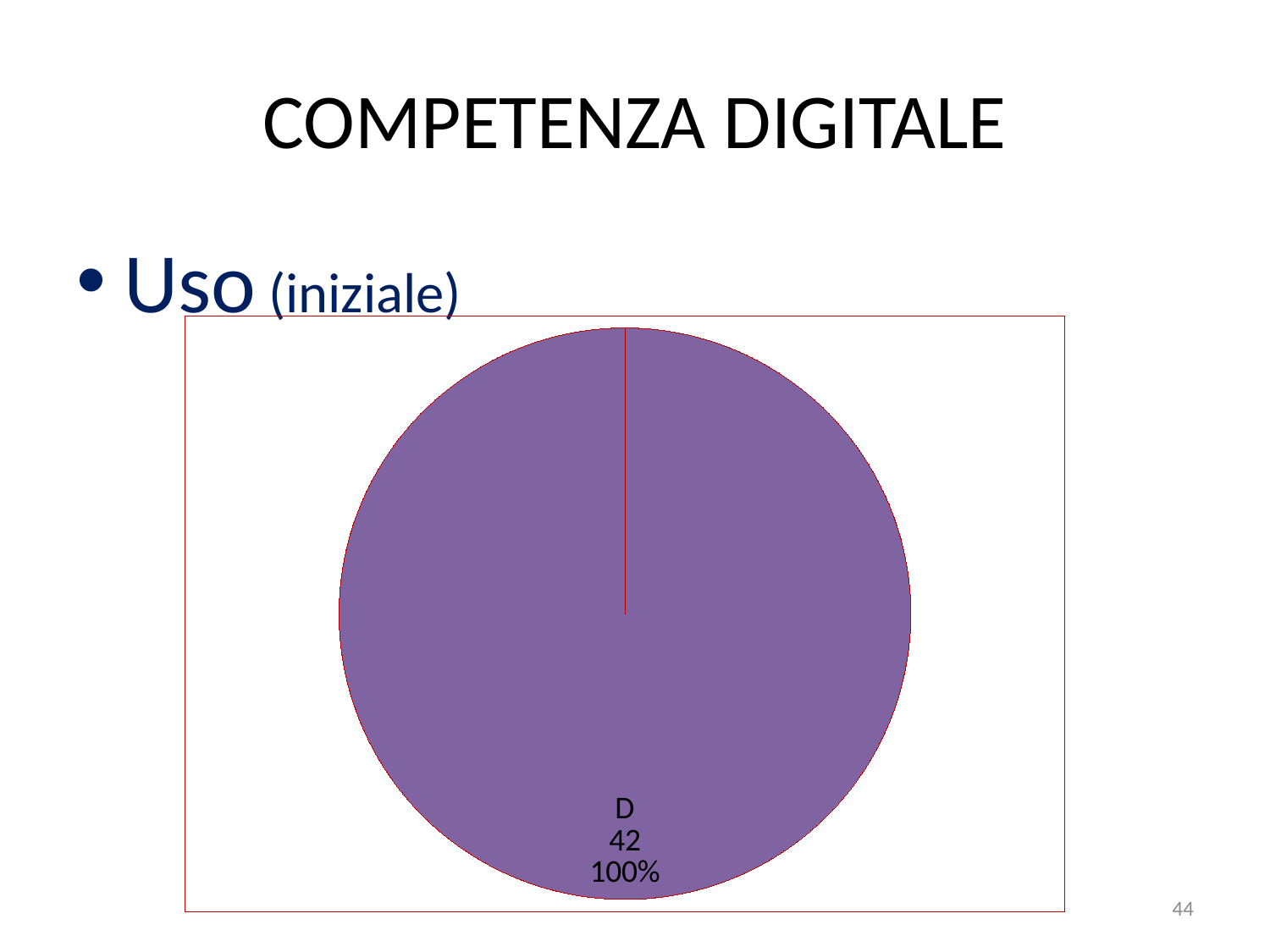
What percentage share of the pie does category D have? 100% Is the value for D in the pie chart greater or less than 40? greater What kind of chart is shown on the slide? pie chart What colour is the slice in the pie chart? purple What is the label of the only slice in the pie chart? D How many slices does the pie chart have? 1 What is the value shown for category D in the pie chart? 42